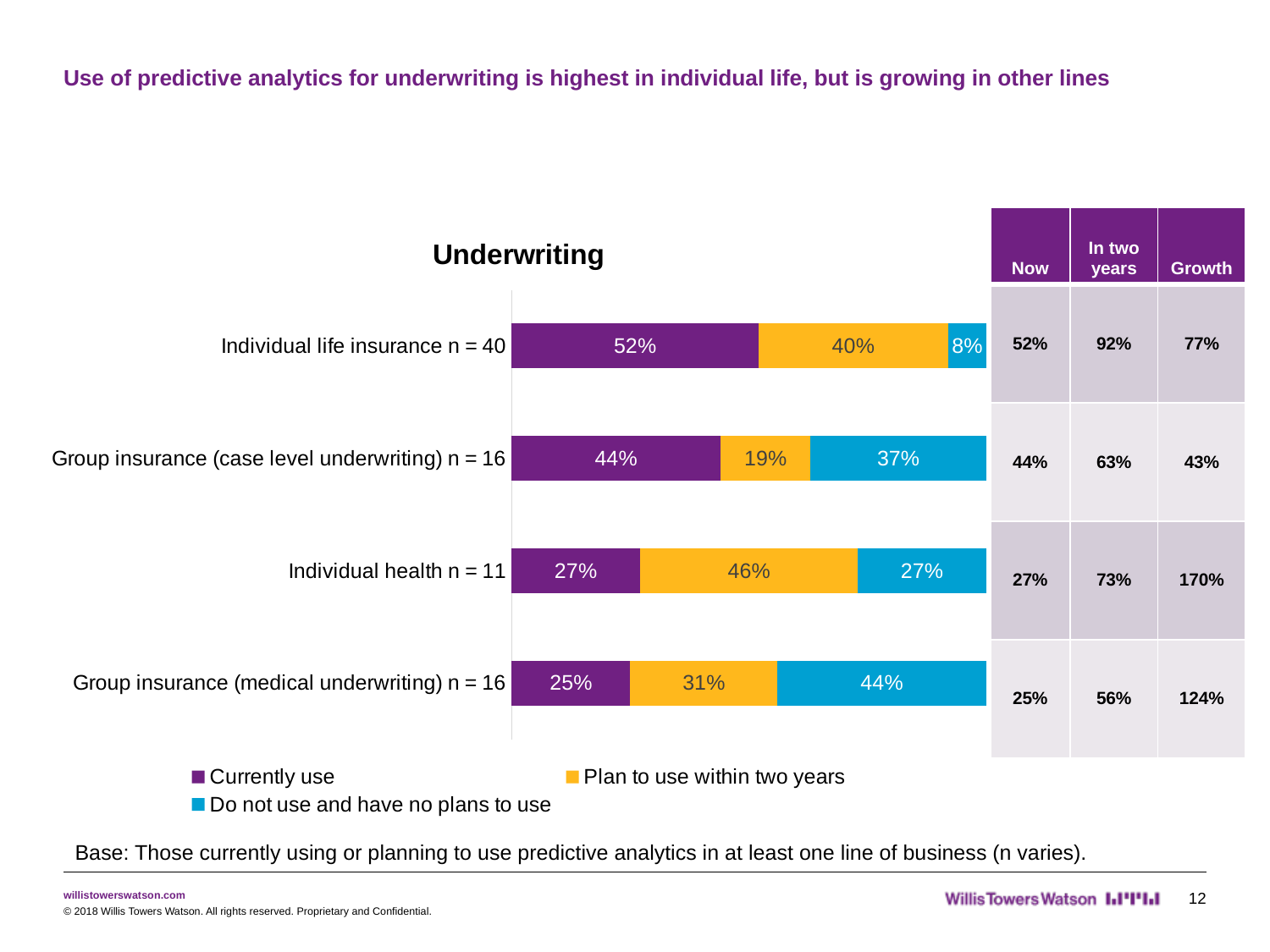
Which is larger: the 'Plan to use within two years' value for Individual life insurance or for Group insurance (medical underwriting)? Individual life insurance How many series does the legend list? 3 What is the 'Currently use' value for Individual life insurance? 52% What is the 'Plan to use within two years' value for Individual health? 46% What is the 'Do not use and have no plans to use' value for Group insurance (medical underwriting)? 44% Which category has the highest 'Currently use' value? Individual life insurance How many categories are shown in the chart? 4 What is the difference between the 'Currently use' values for Individual life insurance and Group insurance (medical underwriting)? 27% What is the 'Plan to use within two years' value for Group insurance (case level underwriting)? 19% What kind of chart is shown on the slide? Stacked bar chart Which category has the lowest 'Do not use and have no plans to use' value? Individual life insurance What is the title of the chart? Underwriting